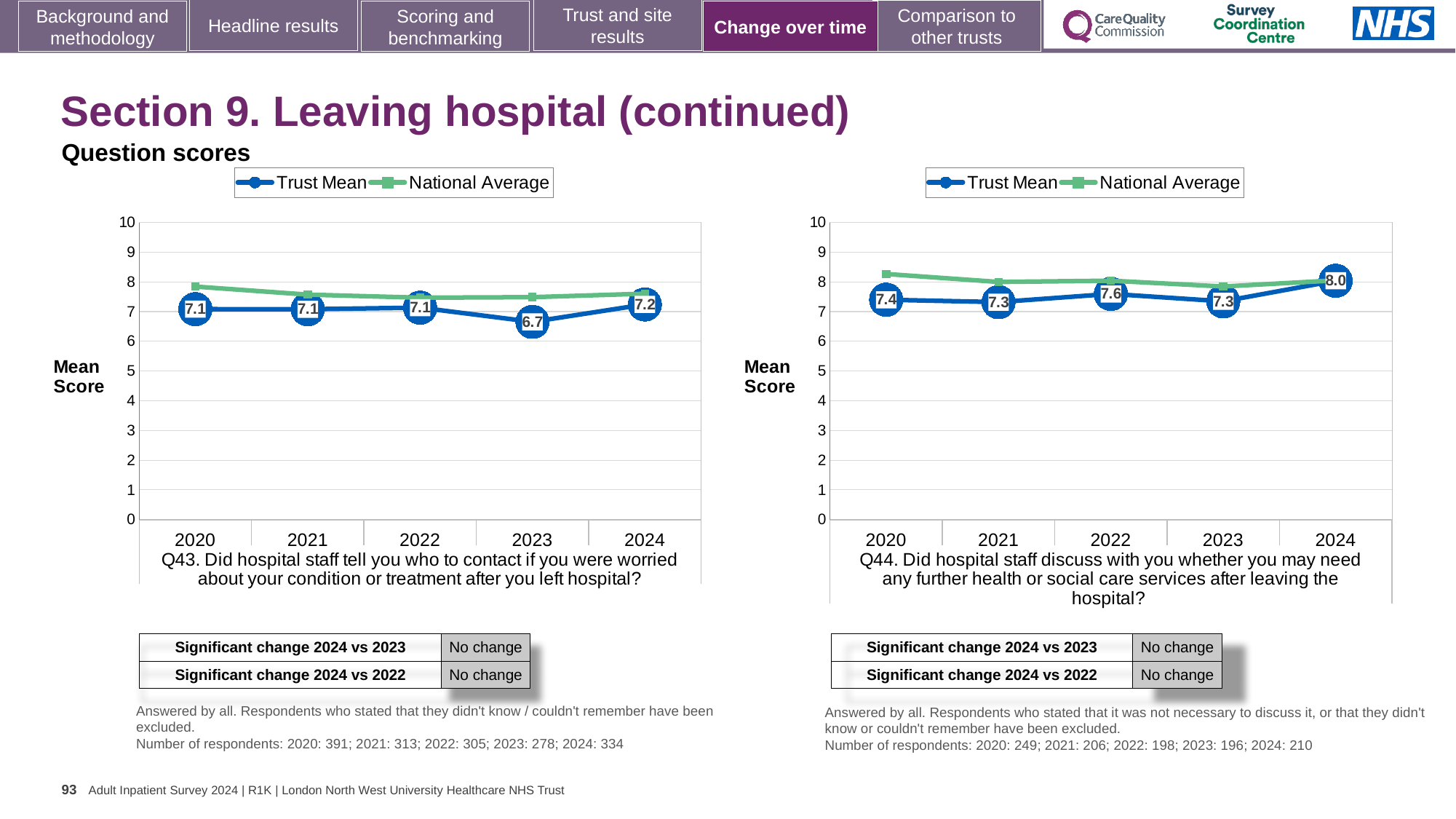
In the Q43 chart (left), is the Trust Mean score for 2024 higher or lower than for 2023? higher In the Q44 chart (right), what is the Trust Mean score for 2024? 8.0 What kind of chart is the Q43 chart (left)? line chart In the Q43 chart (left), which year has the lowest Trust Mean score? 2023 In the Q44 chart (right), is the National Average for 2020 greater or less than 9? less In the Q44 chart (right), what is the difference between the Trust Mean scores for 2024 and 2023? 0.7 In the Q44 chart (right), which year has the highest Trust Mean score? 2024 How many series does the legend of the Q44 chart (right) list? 2 In the Q43 chart (left), is the National Average for 2020 greater or less than 7? greater In the Q44 chart (right), what is the label of the y axis? Mean Score How many years are plotted on the x axis of the Q43 chart (left)? 5 In the Q43 chart (left), what is the Trust Mean score for 2023? 6.7